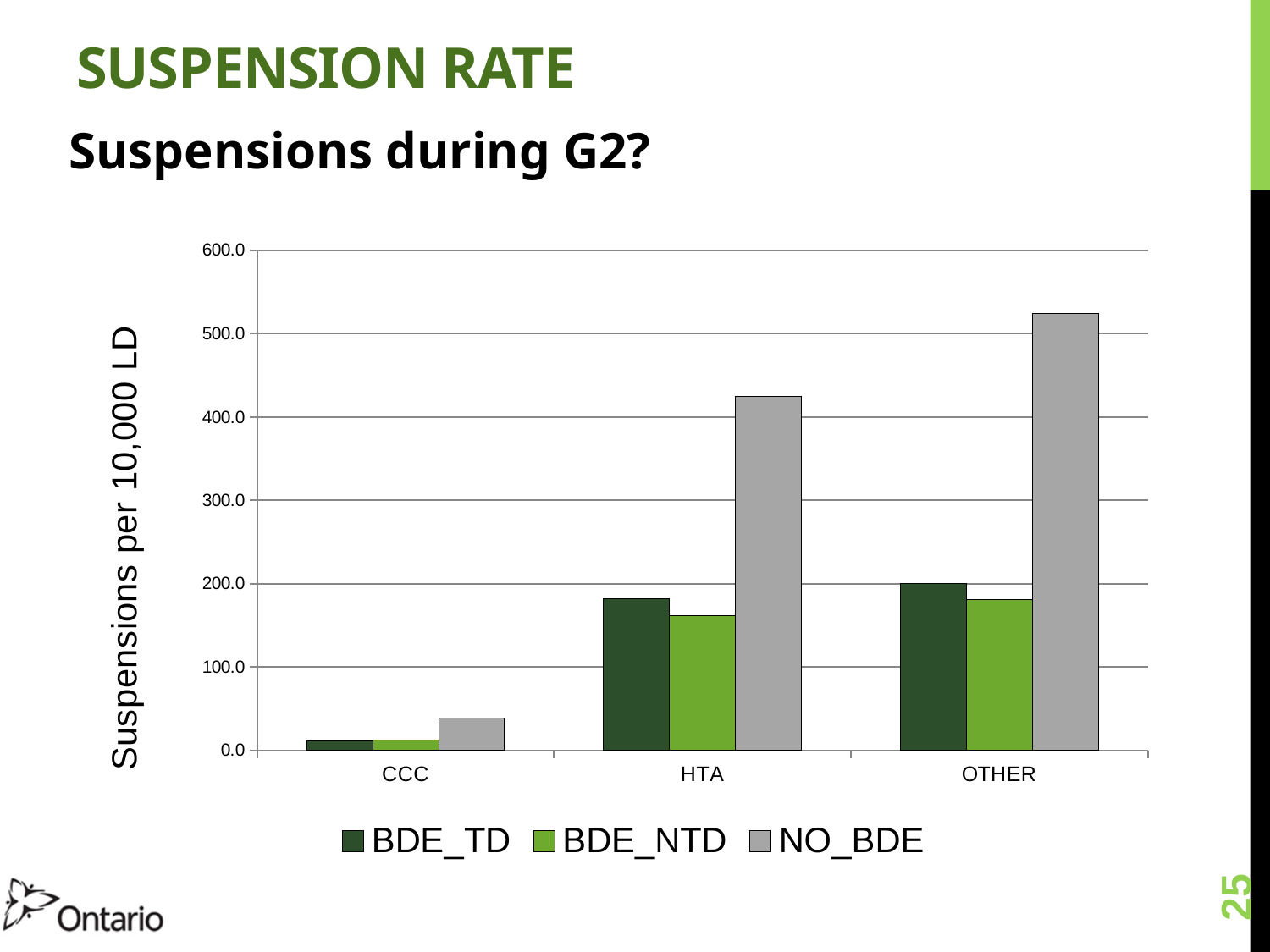
Which category has the lowest values across all three series? CCC Which is larger, the NO_BDE value for HTA or the NO_BDE value for OTHER? OTHER What is the y-axis label of the chart? Suspensions per 10,000 LD How many categories are shown on the x axis? 3 Is the NO_BDE value for HTA greater or less than 400.0? greater Is the BDE_TD value for HTA greater or less than 200.0? less What kind of chart is shown on the slide? bar chart Within the HTA category, which series has the lowest value? BDE_NTD How many series does the legend list? 3 Is the NO_BDE value for OTHER greater or less than 500.0? greater Which category has the highest NO_BDE value? OTHER Which series is shown in grey in the legend? NO_BDE